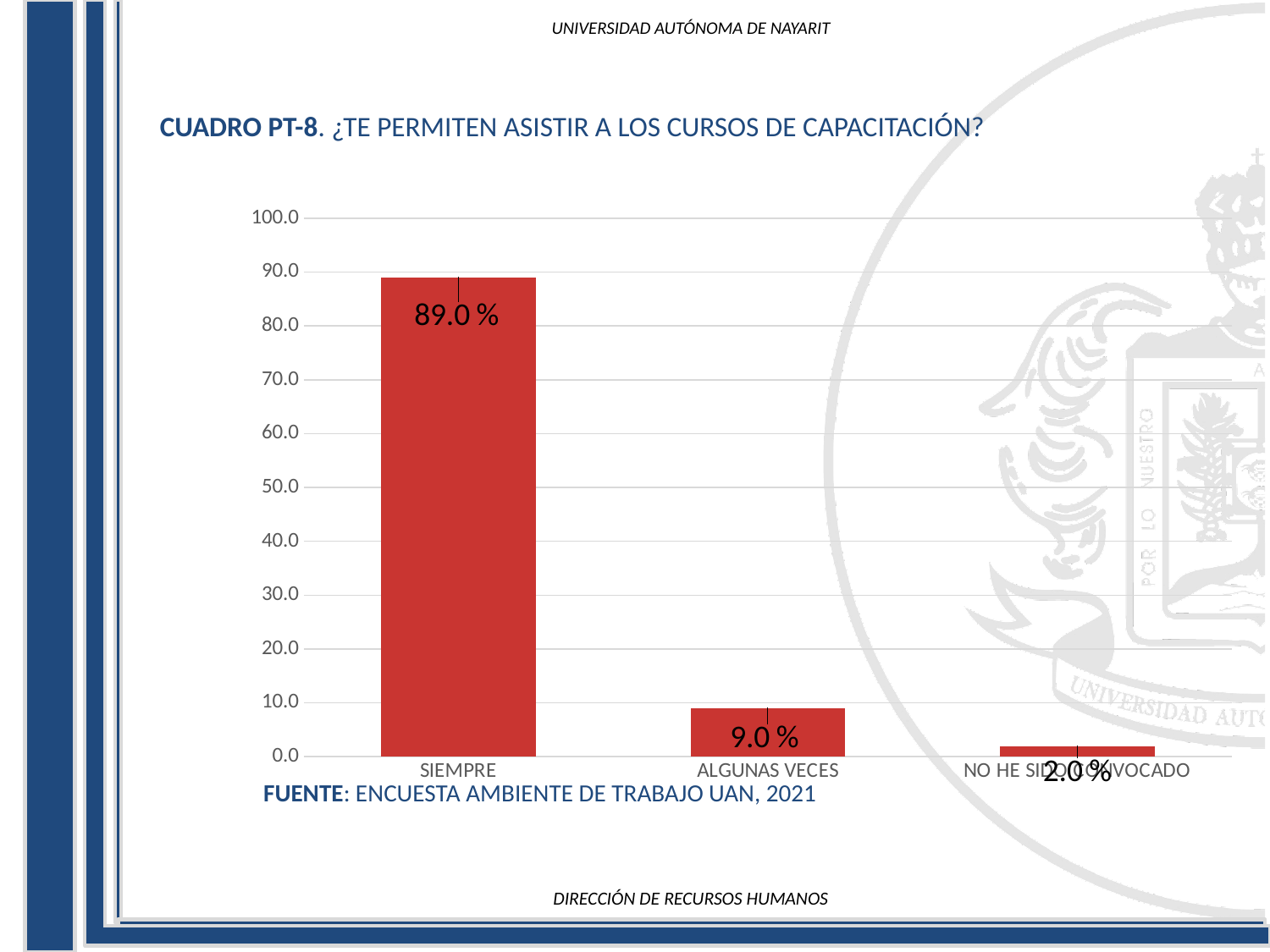
Is the value for SIEMPRE greater or less than 80.0? greater What is the difference between the values for ALGUNAS VECES and NO HE SIDO CONVOCADO? 7.0 % Which category has the lowest value? NO HE SIDO CONVOCADO What is the value for NO HE SIDO CONVOCADO? 2.0 % What is the source cited below the chart? ENCUESTA AMBIENTE DE TRABAJO UAN, 2021 What is the value for ALGUNAS VECES? 9.0 % What kind of chart is shown on the slide? bar chart Which category has the highest value? SIEMPRE What is the value for SIEMPRE? 89.0 % Which is larger, the value for ALGUNAS VECES or the value for NO HE SIDO CONVOCADO? ALGUNAS VECES How many categories are shown on the x axis? 3 What is the difference between the values for SIEMPRE and ALGUNAS VECES? 80.0 %